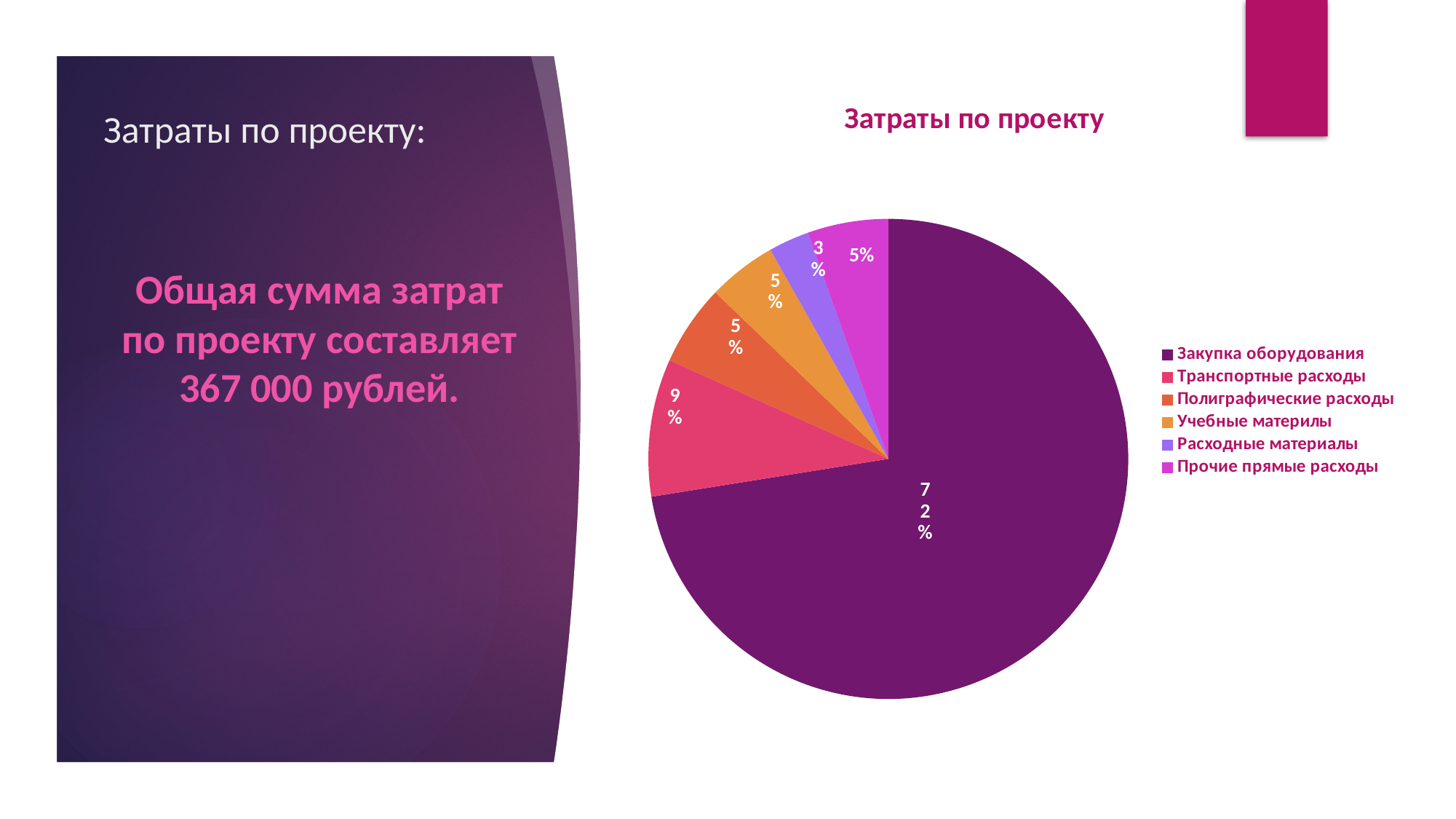
Which is larger, the share of Транспортные расходы or the share of Полиграфические расходы? Транспортные расходы What share of the pie does Закупка оборудования take? 72% Which category has the largest slice of the pie? Закупка оборудования What kind of chart is shown on the slide? pie chart Which category has the smallest slice of the pie? Расходные материалы What share of the pie does Прочие прямые расходы take? 5% Which legend entry is shown in the lightest magenta colour? Прочие прямые расходы What share of the pie does Транспортные расходы take? 9% What is the difference between the shares of Закупка оборудования and Транспортные расходы? 63% What is the title of the chart? Затраты по проекту How many slices does the pie chart have? 6